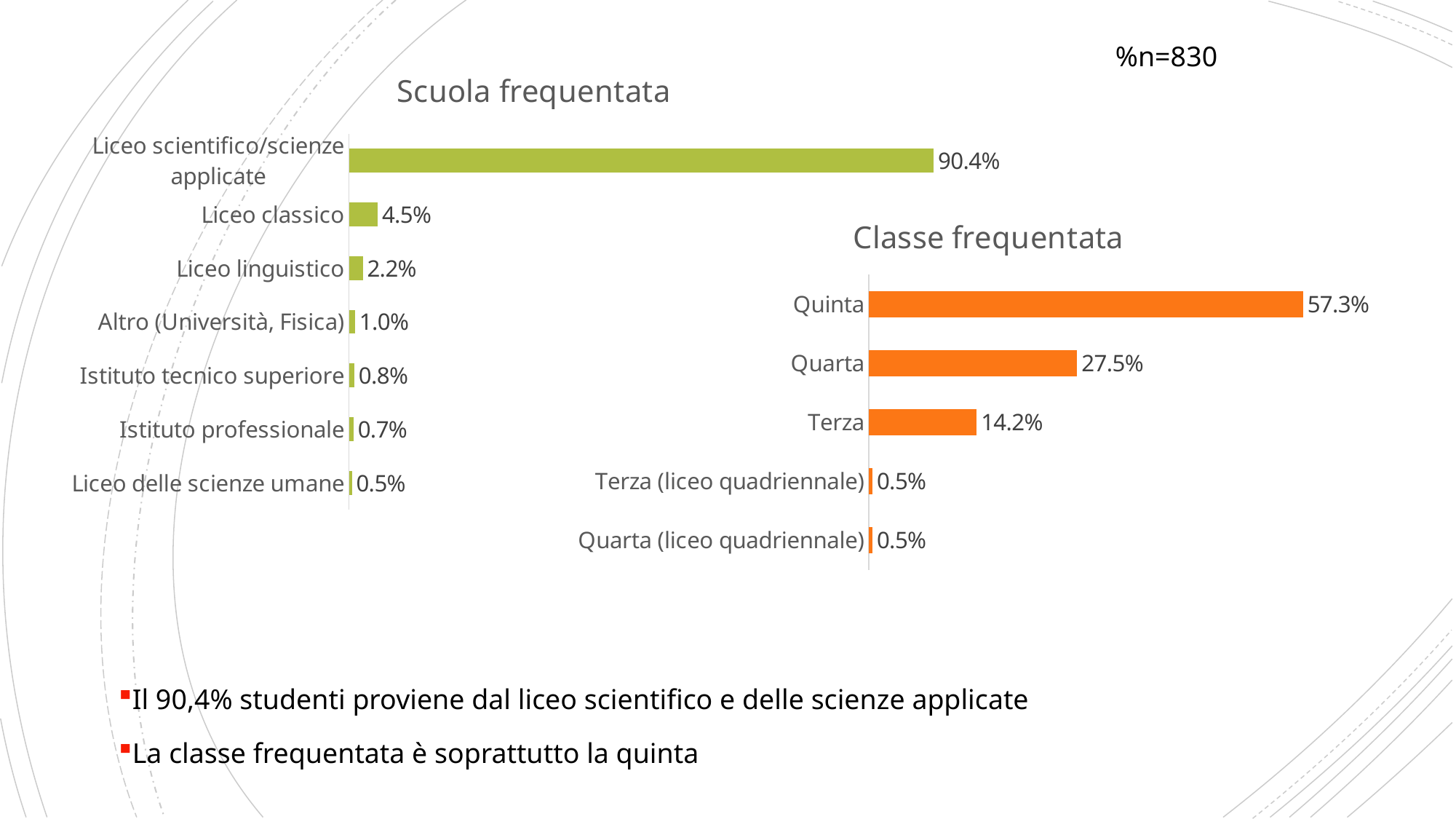
In the 'Scuola frequentata' chart, which category has the lowest value? Liceo delle scienze umane In the 'Classe frequentata' chart, what is the difference between Quinta and Quarta? 29.8% In the 'Classe frequentata' chart, which category has the highest value? Quinta In the 'Classe frequentata' chart, how many categories are shown? 5 What kind of chart is the 'Classe frequentata' chart? Bar chart In the 'Scuola frequentata' chart, what is the value for Liceo linguistico? 2.2% In the 'Scuola frequentata' chart, which category has the highest value? Liceo scientifico/scienze applicate In the 'Scuola frequentata' chart, how many categories are shown? 7 In the 'Scuola frequentata' chart, what is the difference between Liceo scientifico/scienze applicate and Liceo classico? 85.9% In the 'Classe frequentata' chart, what is the value for Quarta? 27.5% In the 'Scuola frequentata' chart, what is the value for Liceo classico? 4.5% In the 'Classe frequentata' chart, what is the value for Terza? 14.2%